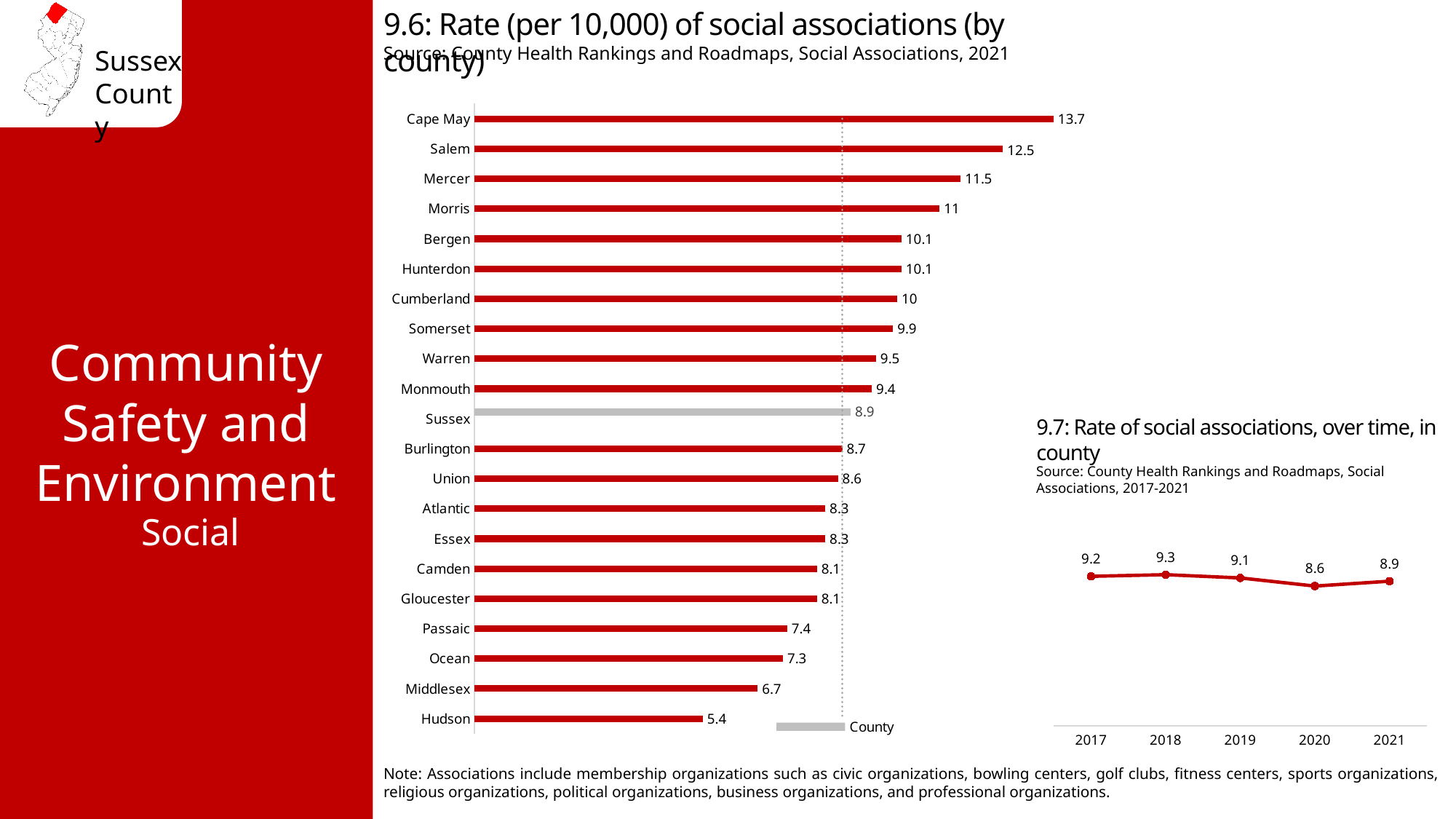
In the chart '9.6: Rate (per 10,000) of social associations (by county)', which has a higher value, Morris or Mercer? Mercer In the chart '9.6: Rate (per 10,000) of social associations (by county)', what is the value for Sussex? 8.9 In the chart '9.6: Rate (per 10,000) of social associations (by county)', which county has the highest rate? Cape May In the chart '9.6: Rate (per 10,000) of social associations (by county)', what is the value for Middlesex? 6.7 What kind of chart is '9.7: Rate of social associations, over time, in county'? Line chart In the chart '9.7: Rate of social associations, over time, in county', which year has the lowest value? 2020 In the chart '9.6: Rate (per 10,000) of social associations (by county)', how many counties are shown? 21 In the chart '9.6: Rate (per 10,000) of social associations (by county)', which county has the lowest rate? Hudson In the chart '9.6: Rate (per 10,000) of social associations (by county)', what is the difference between the values for Cape May and Hudson? 8.3 What kind of chart is '9.6: Rate (per 10,000) of social associations (by county)'? Bar chart In the chart '9.7: Rate of social associations, over time, in county', what is the difference between the values for 2018 and 2020? 0.7 In the chart '9.7: Rate of social associations, over time, in county', what is the value for 2018? 9.3